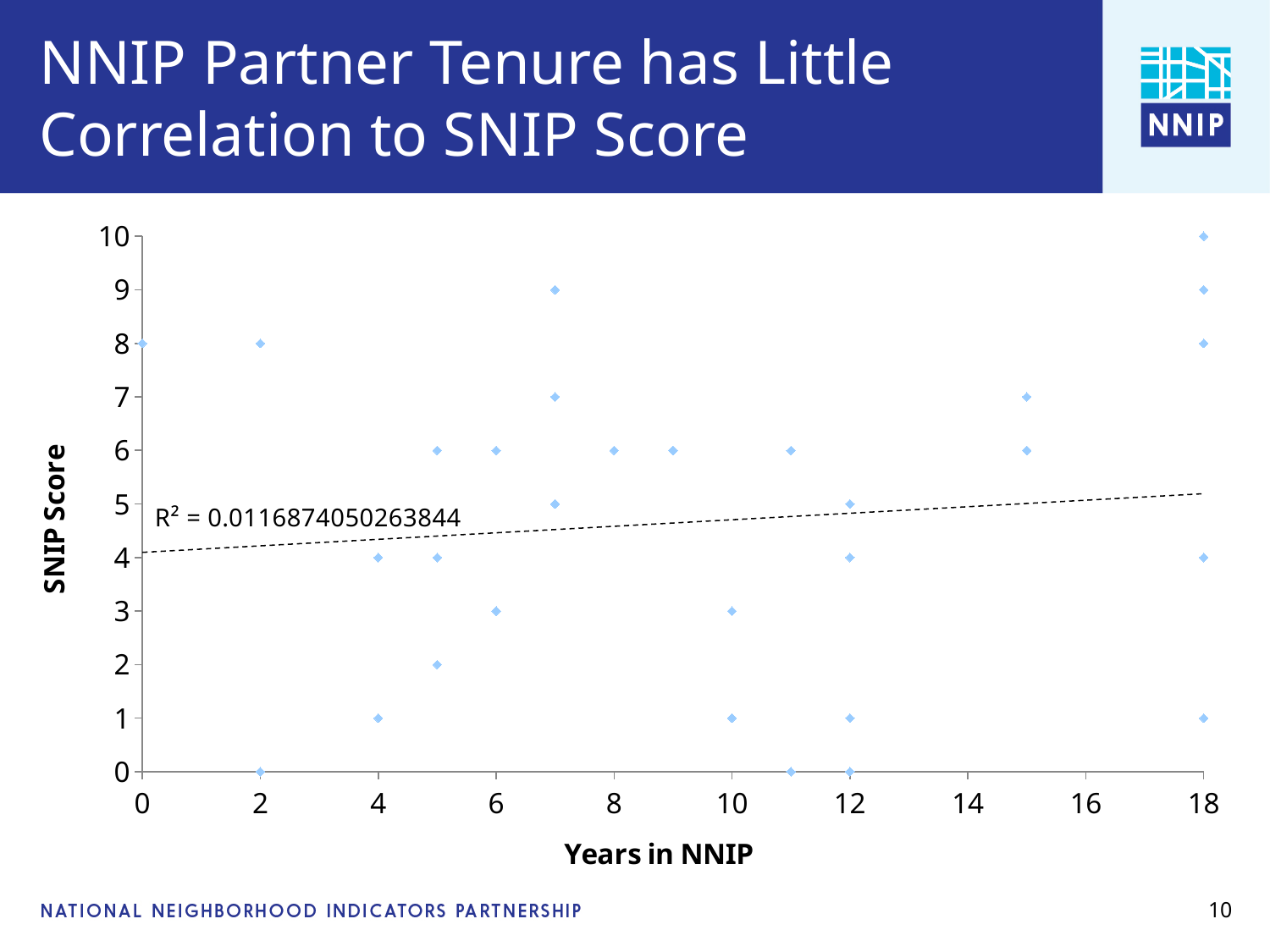
What is the highest SNIP Score among the points at 7 Years in NNIP? 9 How many points are plotted at 18 Years in NNIP? 5 At how many Years in NNIP does the point with the highest SNIP Score (10) appear? 18 What is the SNIP Score of the point at 0 Years in NNIP? 8 What kind of chart is shown on the slide? scatter plot What is the lowest SNIP Score plotted on the chart? 0 Does the dashed trend line rise or fall as Years in NNIP increases? rises What is the highest SNIP Score plotted on the chart? 10 What R² value is printed on the chart? R² = 0.0116874050263844 Which is larger: the highest SNIP Score at 15 Years in NNIP or the highest SNIP Score at 7 Years in NNIP? 7 Years in NNIP What is the label of the x axis? Years in NNIP